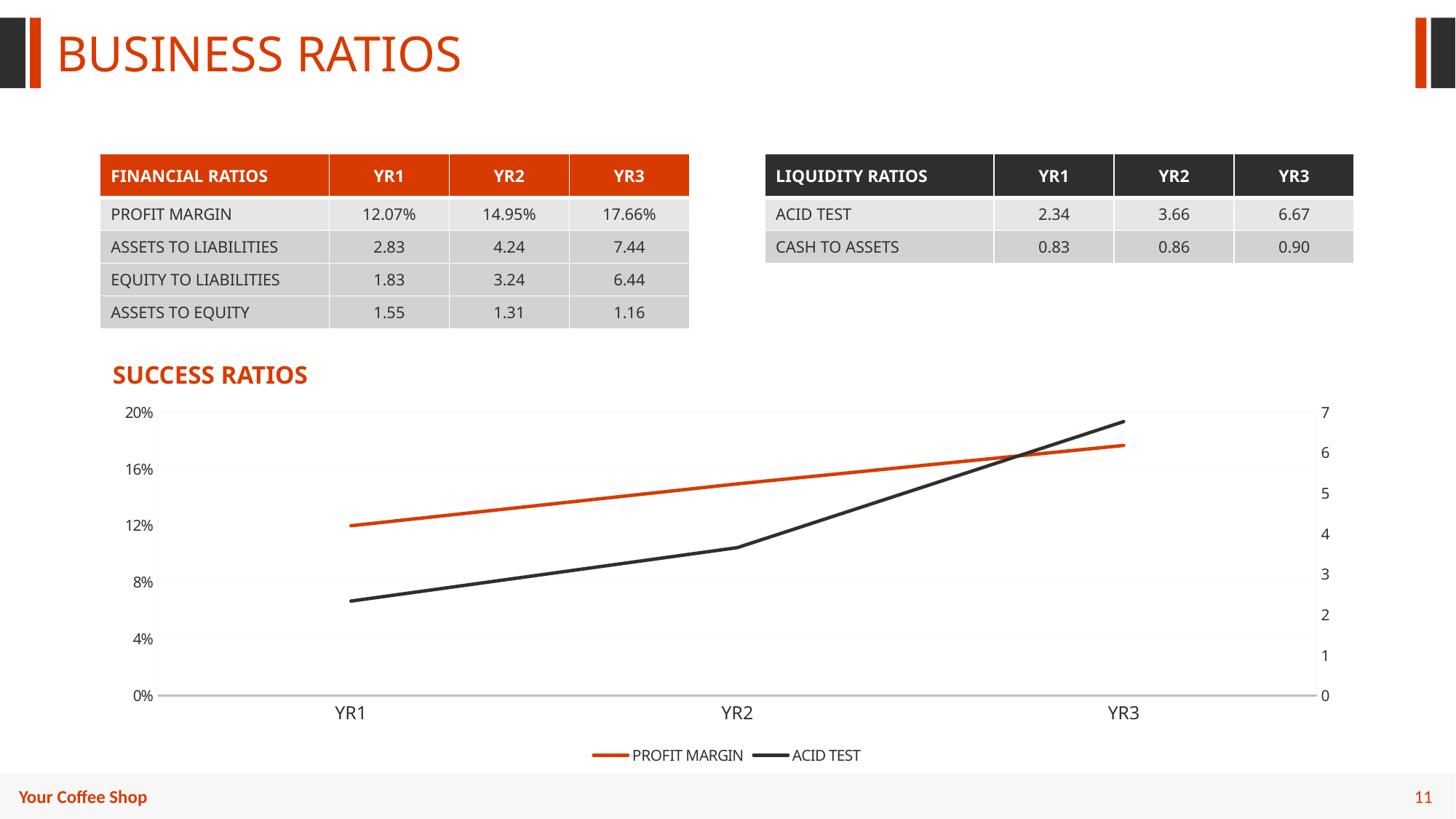
What kind of chart is the SUCCESS RATIOS chart? line chart In the SUCCESS RATIOS chart, is the ACID TEST value for YR3 greater or less than 6? greater In the SUCCESS RATIOS chart, which year has the lowest ACID TEST value? YR1 In the SUCCESS RATIOS chart, what colour is the ACID TEST line? black How many points are plotted along the x axis of the SUCCESS RATIOS chart? 3 In the SUCCESS RATIOS chart, which year has the highest PROFIT MARGIN? YR3 In the SUCCESS RATIOS chart, does the PROFIT MARGIN line rise or fall from YR1 to YR3? rise In the SUCCESS RATIOS chart, is the PROFIT MARGIN value for YR1 greater or less than 16%? less In the SUCCESS RATIOS chart, does the ACID TEST line rise or fall from YR1 to YR3? rise In the SUCCESS RATIOS chart, is the ACID TEST value for YR1 greater or less than 3? less How many series does the legend of the SUCCESS RATIOS chart list? 2 What is the PROFIT MARGIN value for YR3 plotted in the SUCCESS RATIOS chart? 17.66%